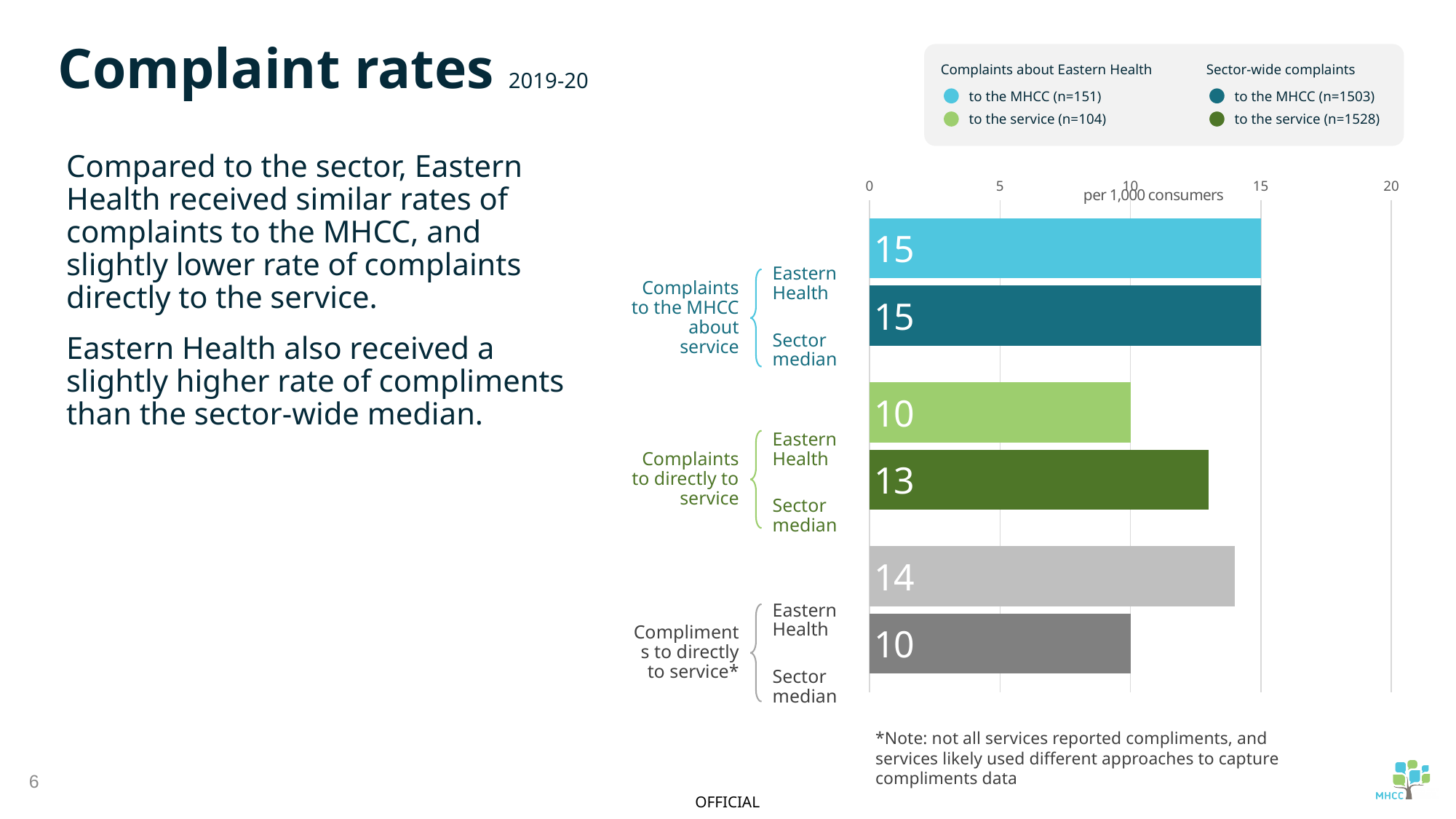
What type of chart is shown on the slide? Bar chart What is the sector median rate of compliments directly to service? 10 How many bars are plotted on the chart? 6 Which bar has the lowest value on the chart? Eastern Health complaints directly to service and sector median compliments directly to service (both 10) What is the difference between the sector median and Eastern Health for complaints directly to service? 3 What unit is the horizontal axis of the chart measured in? per 1,000 consumers What is the difference between Eastern Health and the sector median for compliments directly to service? 4 What is the rate of compliments directly to service for Eastern Health? 14 What is the rate of complaints to the MHCC about service for Eastern Health? 15 For compliments directly to service, which is larger: Eastern Health or the sector median? Eastern Health What is the sector median rate of complaints directly to service? 13 For complaints directly to service, which is larger: Eastern Health or the sector median? Sector median